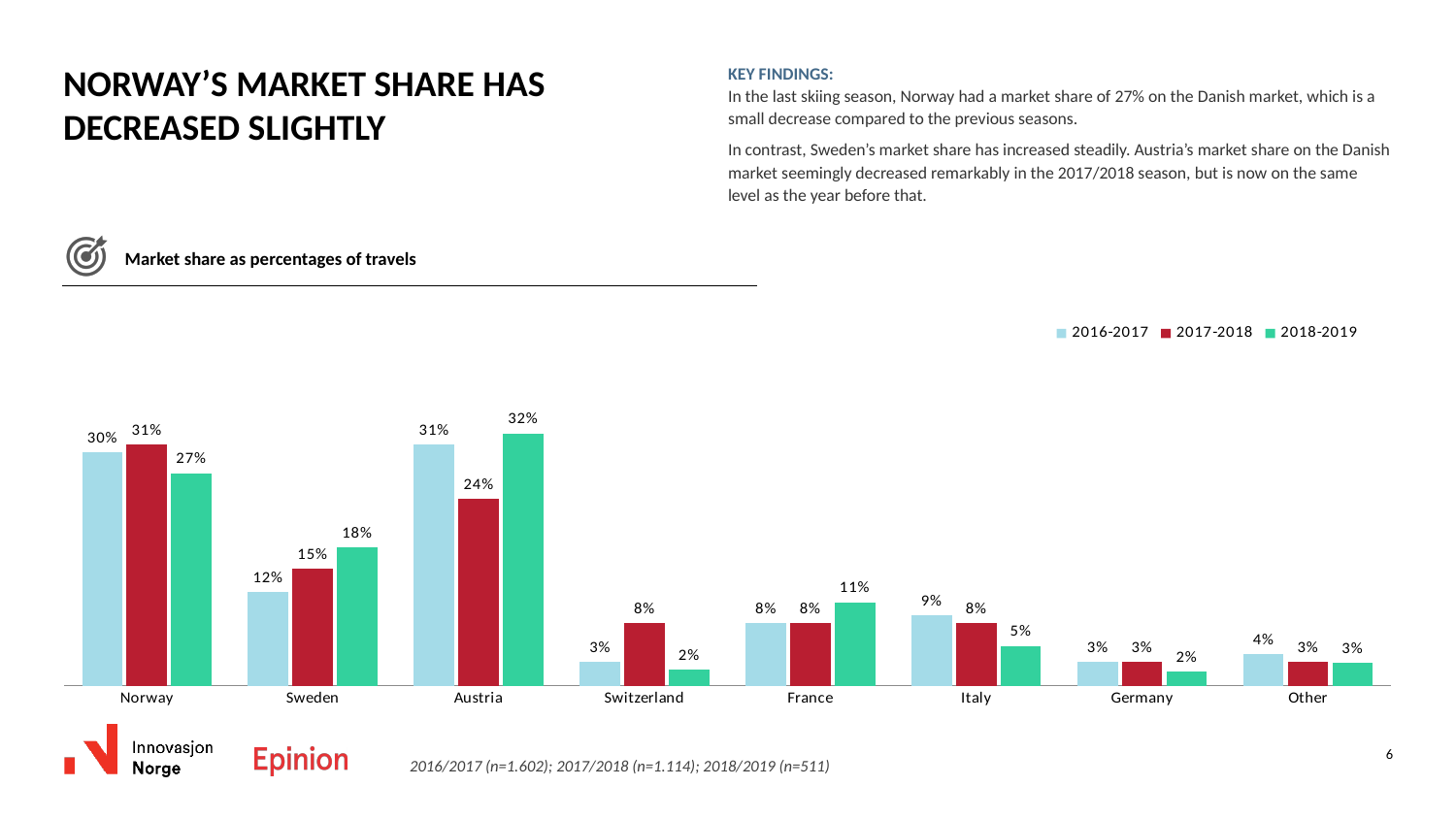
What kind of chart is shown on the slide? Bar chart Which is larger: Norway's 2016-2017 market share or Austria's 2016-2017 market share? Austria How many series does the legend list? 3 Do Sweden's market share values rise or fall from 2016-2017 to 2018-2019? Rise What is Austria's market share for 2017-2018? 24% What is the difference between Austria's 2018-2019 and 2017-2018 market shares? 8% What is Norway's market share for 2018-2019? 27% Which country has the highest market share in the 2018-2019 series? Austria How many countries or categories are shown on the x axis? 8 Which season does the red series in the legend represent? 2017-2018 Which category has the lowest value in the 2017-2018 series? Germany and Other (both 3%) What is Sweden's market share for 2016-2017? 12%